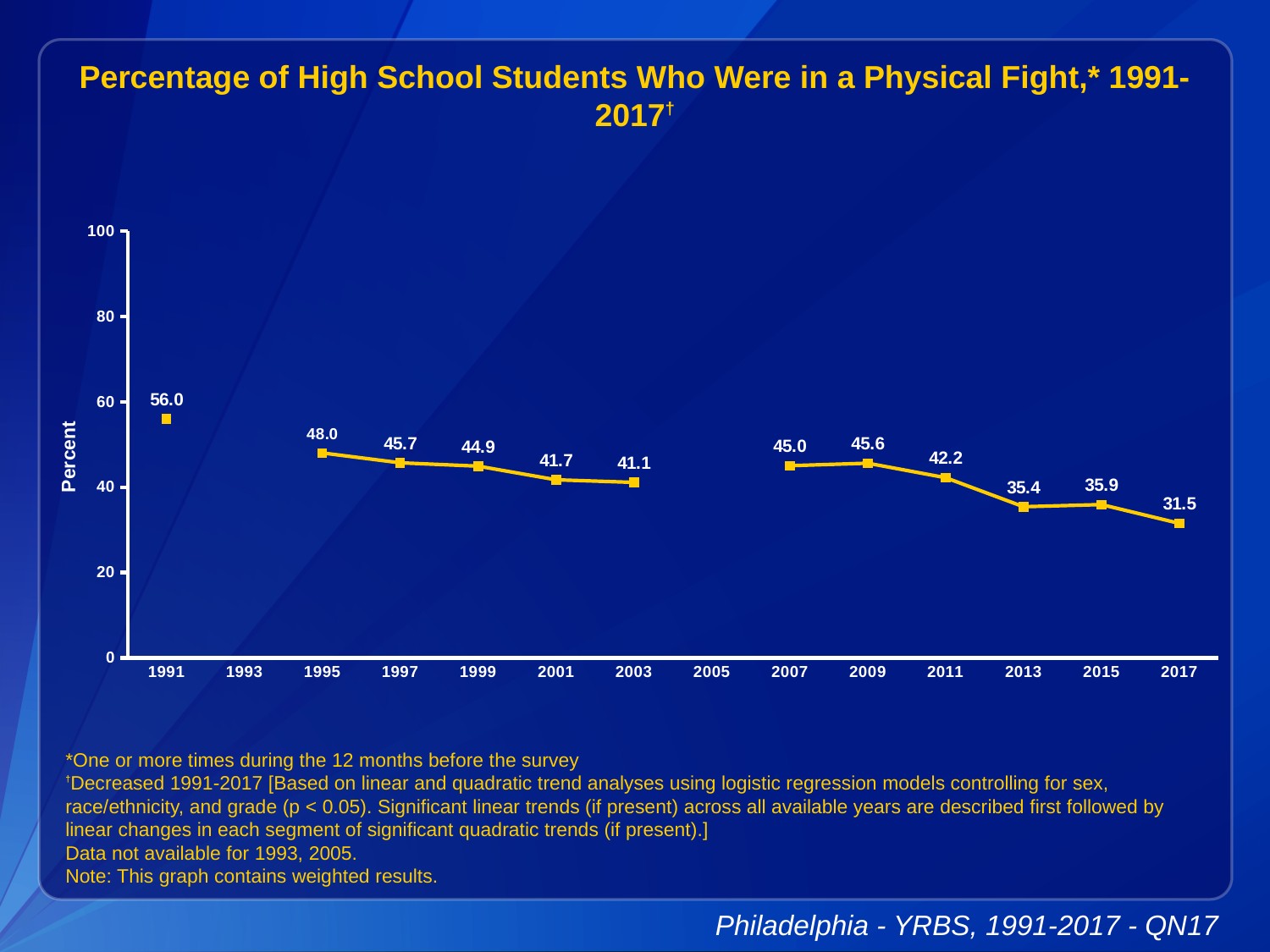
What kind of chart is shown on the slide? line chart What is the difference between the values for 1991 and 2017? 24.5 Which is larger, the value for 2007 or the value for 2011? 2007 Which year has the highest value? 1991 What is the value for 2017? 31.5 What is the value for 1991? 56.0 How many years have data points plotted on the chart? 12 What is the value for 2009? 45.6 Do the values generally rise or fall from 1991 to 2017? fall Is the value for 2013 greater or less than 40? less Which year has the lowest value? 2017 What is the label on the y axis? Percent